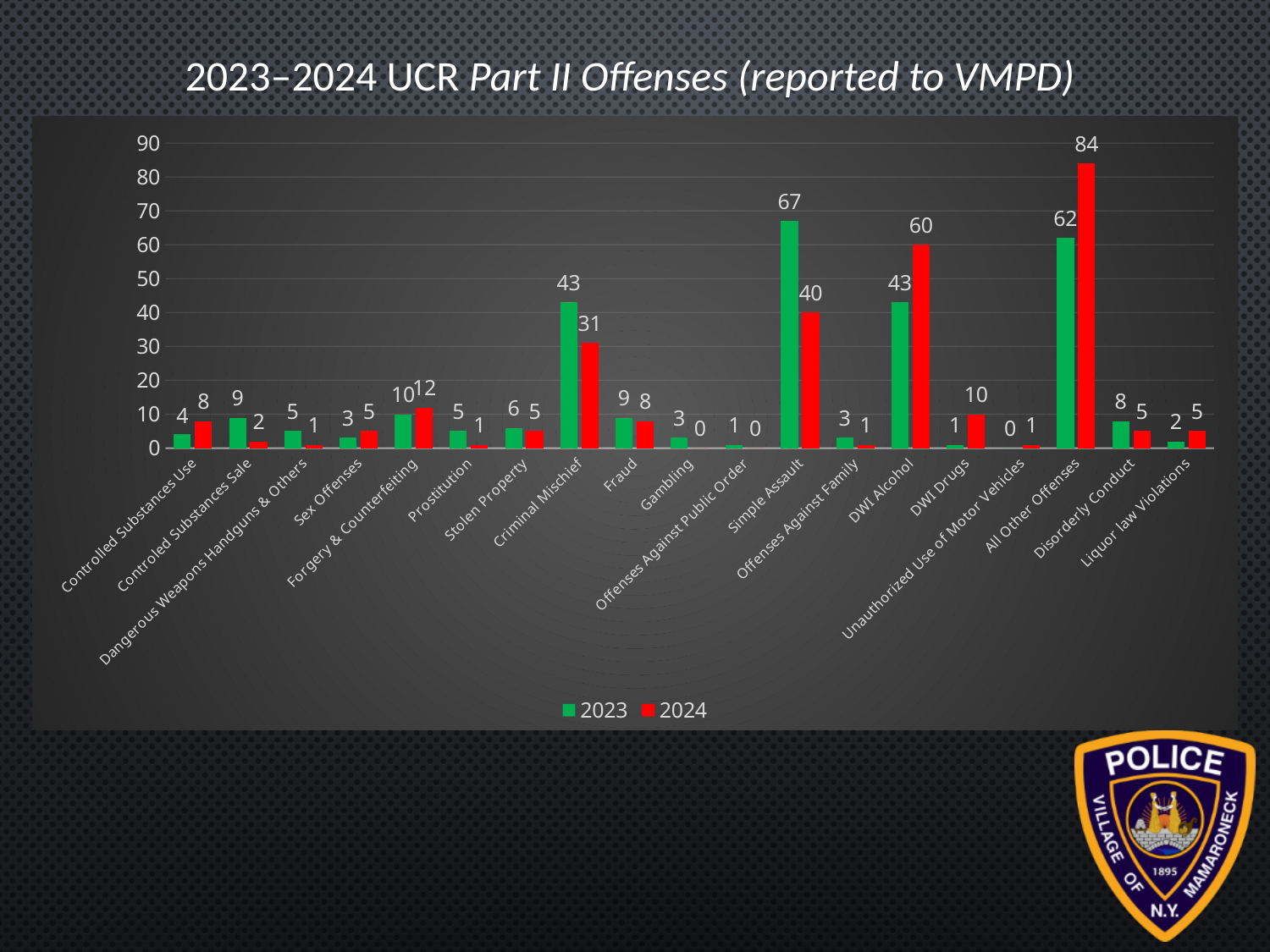
What is the 2024 value for DWI Drugs? 10 Which category has the highest 2024 value? All Other Offenses What is the 2023 value for Criminal Mischief? 43 How many offense categories are shown on the x axis? 19 Which category has the highest 2023 value? Simple Assault What is the difference between the 2023 and 2024 values for Simple Assault? 27 What is the difference between the 2024 and 2023 values for All Other Offenses? 22 For Criminal Mischief, which year has the larger value, 2023 or 2024? 2023 What is the 2024 value for Simple Assault? 40 How many series does the legend list? 2 What type of chart is shown on the slide? Bar chart For DWI Alcohol, which year has the larger value, 2023 or 2024? 2024